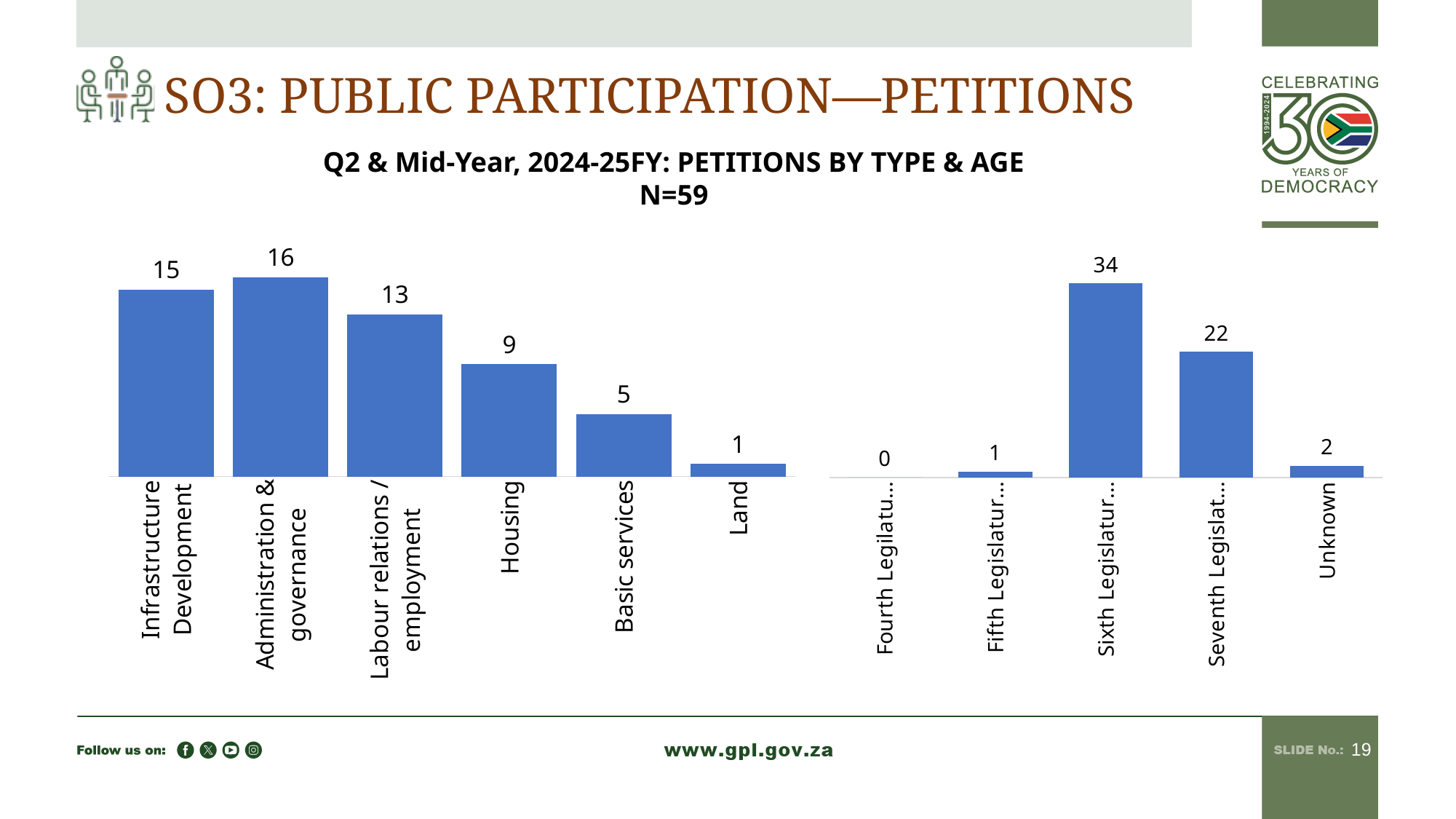
On the left chart (petitions by type), how many categories are shown? 6 On the left chart (petitions by type), what is the difference between Infrastructure Development and Basic services? 10 On the left chart (petitions by type), which is larger: Labour relations / employment or Housing? Labour relations / employment What is the N value stated in the chart title? N=59 On the right chart (petitions by age), what is the value for the Fourth Legislature? 0 On the right chart (petitions by age), which category has the highest value? Sixth Legislature On the right chart (petitions by age), what is the difference between the Sixth Legislature and the Seventh Legislature? 12 On the left chart (petitions by type), which category has the highest value? Administration & governance On the left chart (petitions by type), how many petitions are for Housing? 9 On the left chart (petitions by type), which category has the lowest value? Land What type of chart is used on this slide? Bar chart On the right chart (petitions by age), what is the value for Unknown? 2